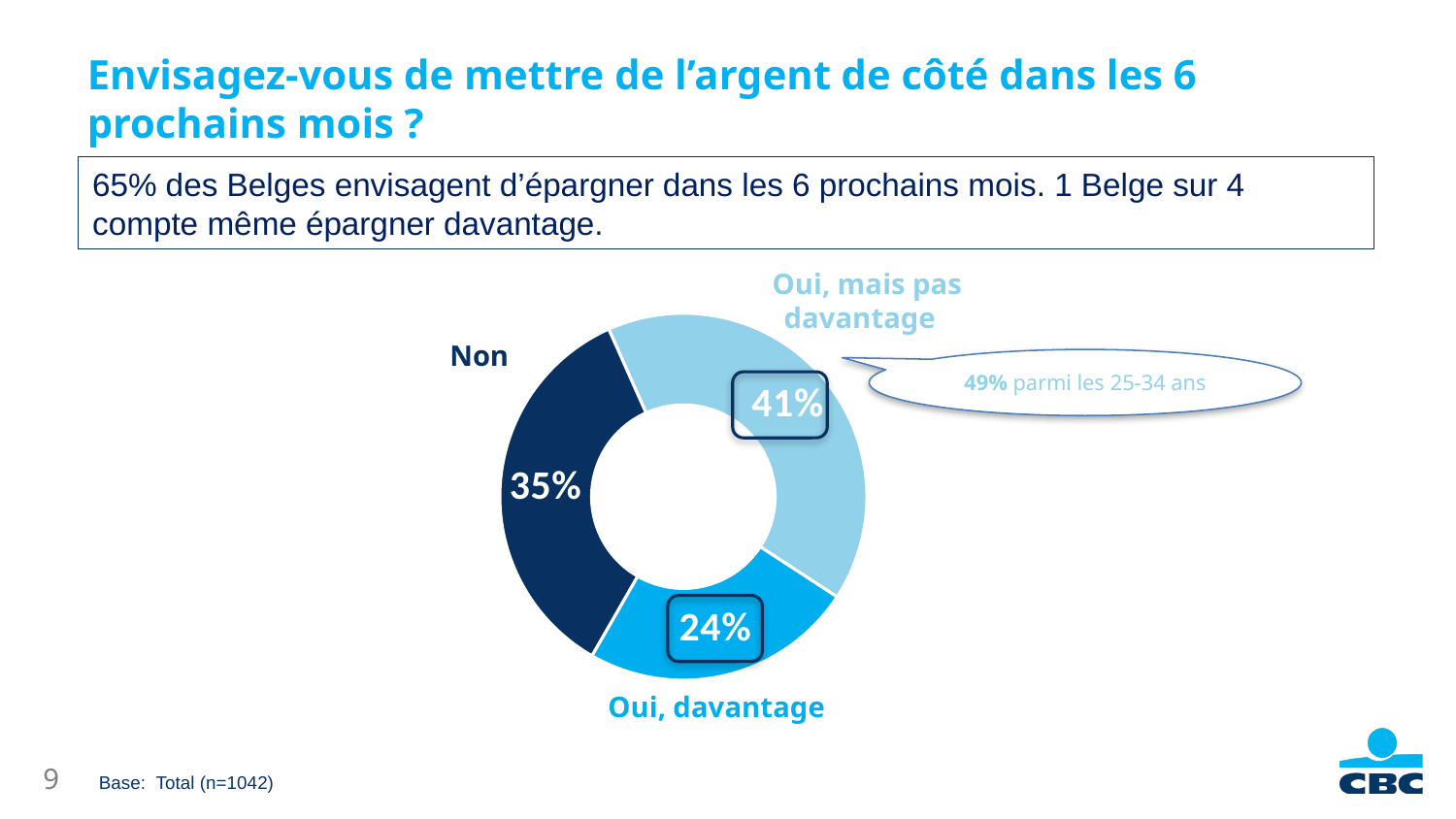
How many categories does the chart show? 3 Which response has the smallest share of the chart? Oui, davantage What is the difference in percentage points between "Non" and "Oui, davantage"? 11 Which is larger: the share for "Non" or the share for "Oui, davantage"? Non According to the callout, what percentage of 25-34 year olds answered "Oui, mais pas davantage"? 49% What kind of chart is shown on the slide? Pie chart (doughnut) What percentage of respondents answered "Oui, mais pas davantage"? 41% What percentage of respondents answered "Non"? 35% What percentage of respondents answered "Oui, davantage"? 24% Which response has the largest share of the chart? Oui, mais pas davantage What is the combined share of the two "Oui" responses? 65% What is the difference in percentage points between "Oui, mais pas davantage" and "Non"? 6